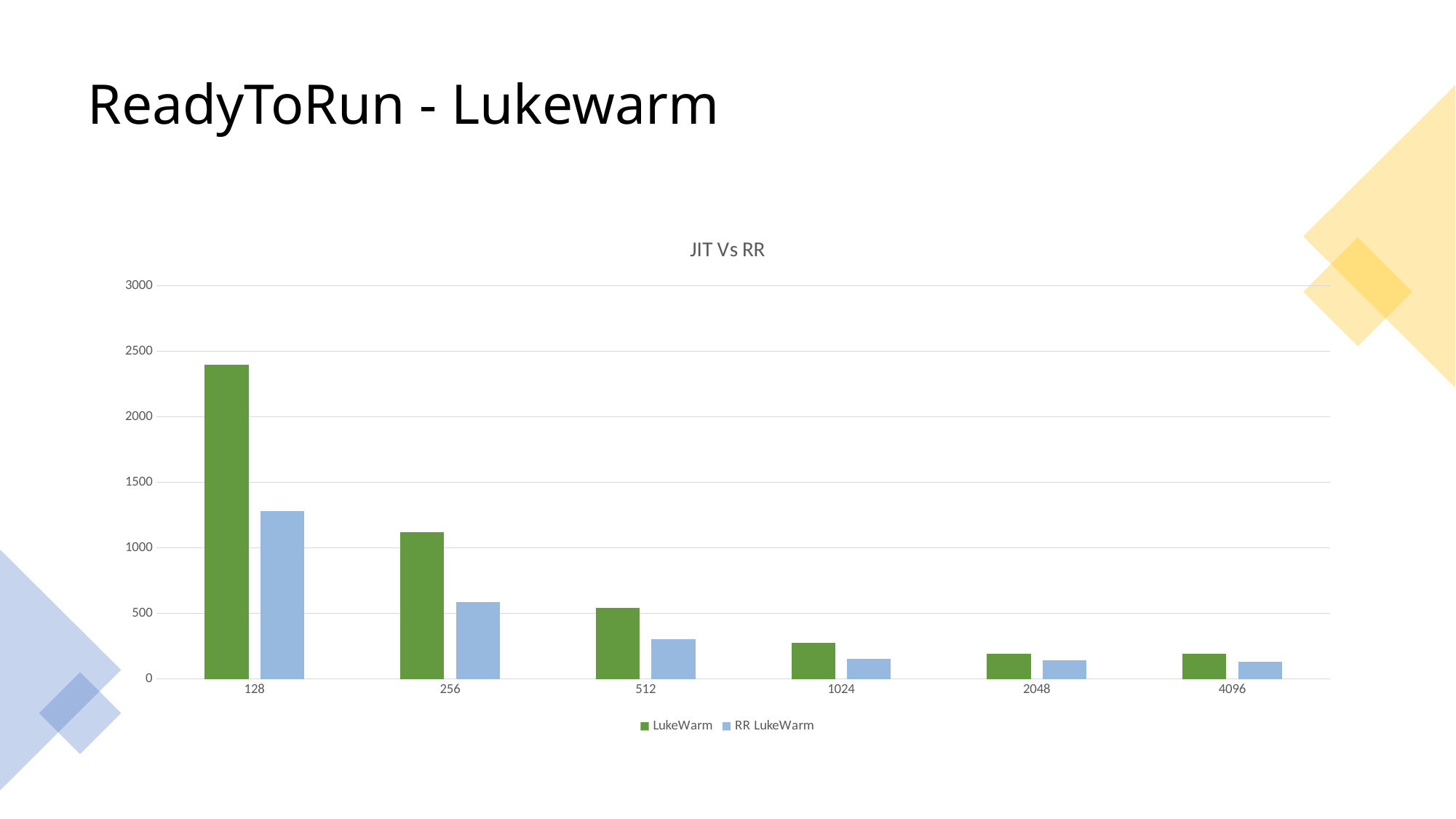
Which category has the highest LukeWarm value? 128 Is the LukeWarm value for 128 greater or less than 2000? greater How many categories are shown on the x axis? 6 How many series does the legend list? 2 Which is larger at 256, the LukeWarm value or the RR LukeWarm value? LukeWarm What type of chart is shown on the slide? bar chart Is the RR LukeWarm value for 512 greater or less than 500? less Is the LukeWarm value for 256 greater or less than 1000? greater Which category has the highest RR LukeWarm value? 128 Do the LukeWarm values rise or fall as the x axis goes from 128 to 1024? fall What is the title of the chart? JIT Vs RR